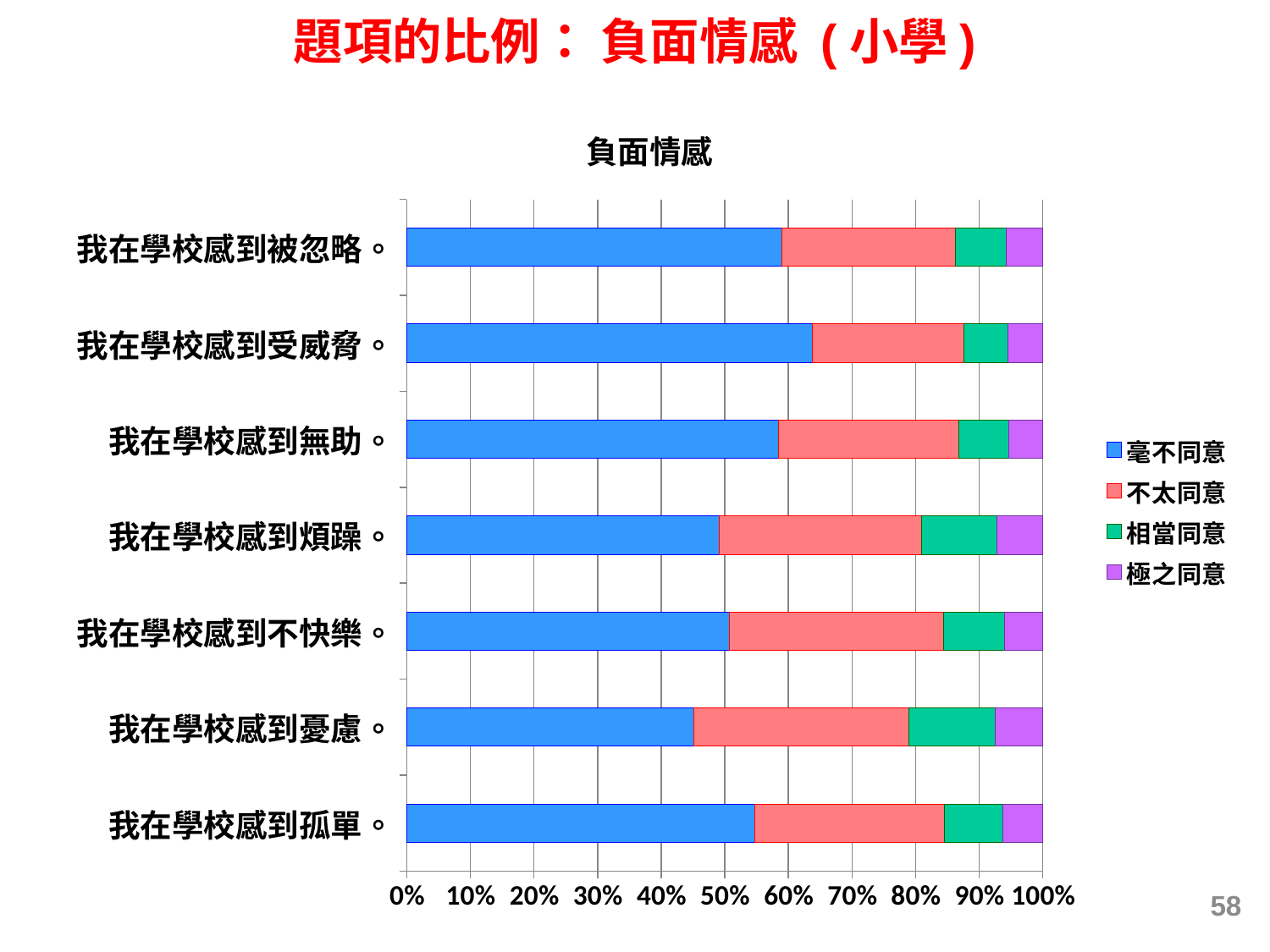
Is the 毫不同意 share for 我在學校感到受威脅 greater or less than 60%? greater Which has a larger 毫不同意 share: 我在學校感到受威脅 or 我在學校感到憂慮? 我在學校感到受威脅 Which statement has the largest 毫不同意 share? 我在學校感到受威脅 How many statements (categories) are plotted in the chart? 7 Is the 毫不同意 share for 我在學校感到孤單 greater or less than 50%? greater Which legend entry is shown in purple? 極之同意 Which statement has the smallest 毫不同意 share? 我在學校感到憂慮 What is the title of the chart? 負面情感 How many series does the legend list? 4 Is the 毫不同意 share for 我在學校感到被忽略 greater or less than 50%? greater What kind of chart is shown on the slide? Stacked bar chart